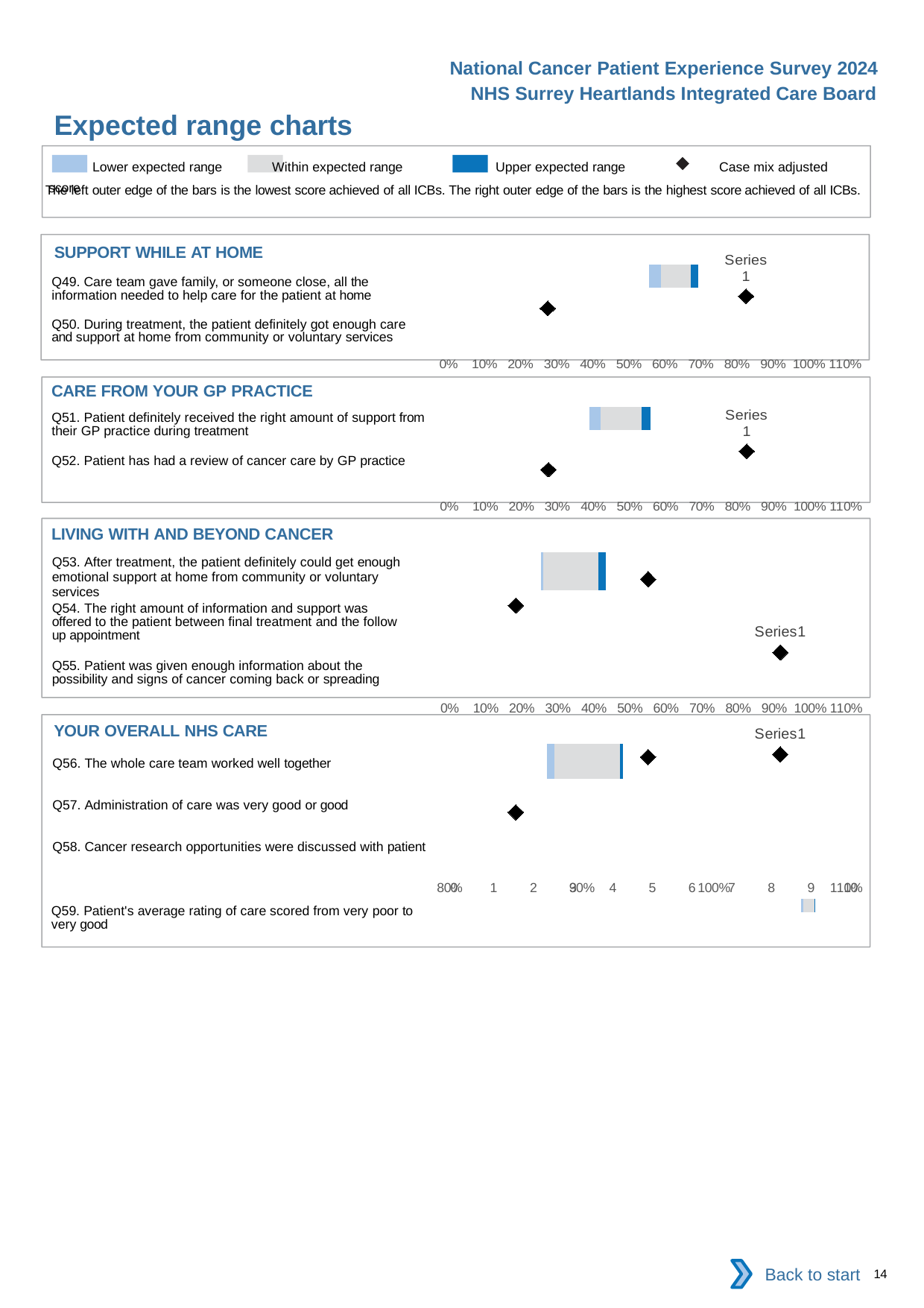
In the LIVING WITH AND BEYOND CANCER chart, how many question rows are listed? 3 In the SUPPORT WHILE AT HOME chart, is the rightmost diamond marker greater or less than 70%? greater According to the legend, what does the dark blue colour represent? Upper expected range In the LIVING WITH AND BEYOND CANCER chart, is the rightmost diamond marker greater or less than 80%? greater In the CARE FROM YOUR GP PRACTICE chart, is the leftmost diamond marker greater or less than 40%? less In the LIVING WITH AND BEYOND CANCER chart, how many black diamond markers are plotted? 3 According to the legend, what does the black diamond marker represent? Case mix adjusted score In the SUPPORT WHILE AT HOME chart, how many question rows are listed? 2 What kind of chart is used in the SUPPORT WHILE AT HOME section? bar chart